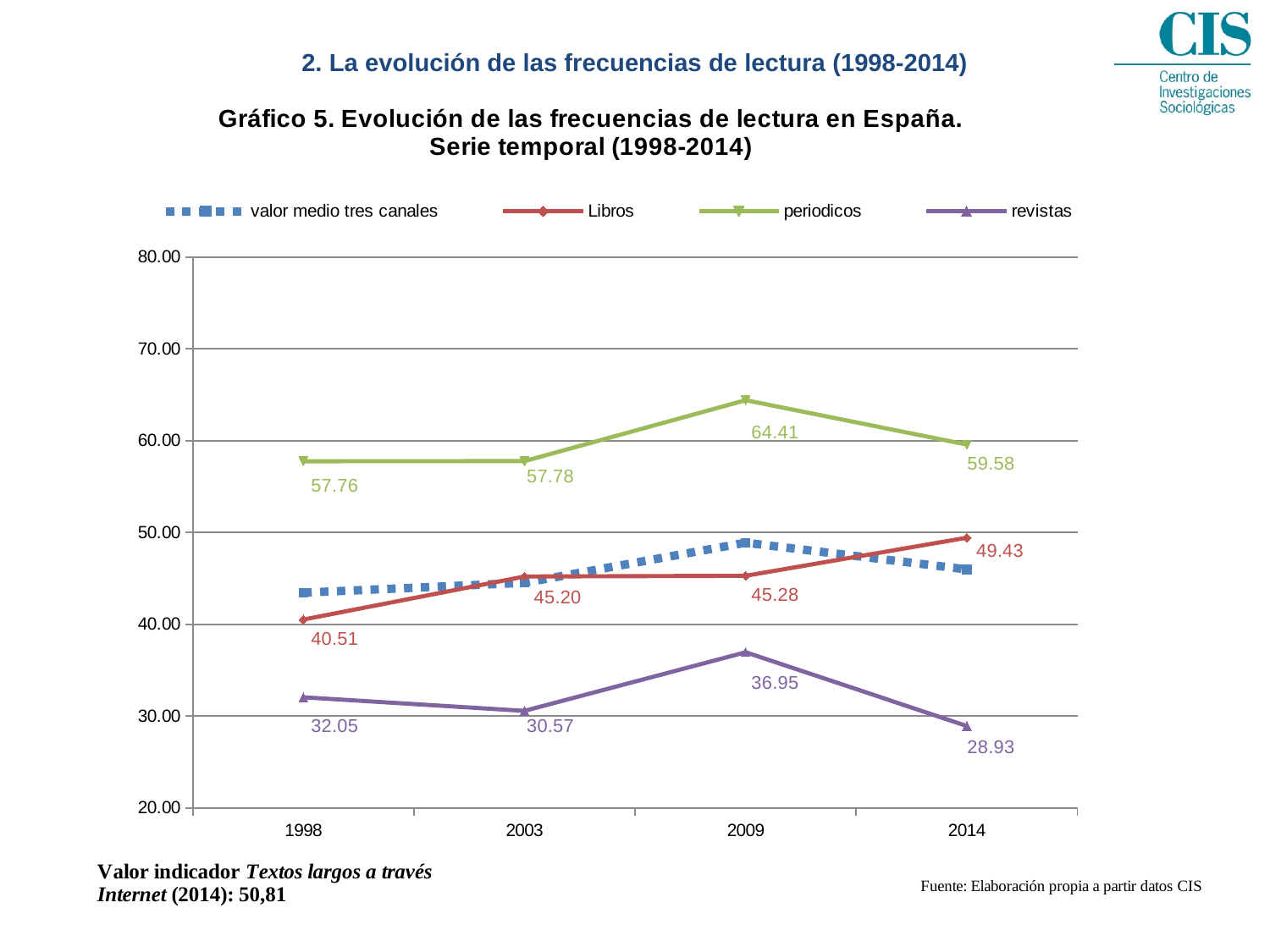
What type of chart is shown on the slide? line chart What is the value for periodicos in 2009? 64.41 What is the value for Libros in 1998? 40.51 Is the value for valor medio tres canales in 2009 greater or less than 40.00? greater In which year is the value for periodicos highest? 2009 Does the value for Libros rise or fall from 1998 to 2014? rise Which is larger in 2003, the value for Libros or the value for revistas? Libros How many series does the legend list? 4 What is the value for revistas in 2014? 28.93 How many years are plotted along the x axis? 4 What is the difference between the Libros values in 2014 and 1998? 8.92 In which year is the value for revistas lowest? 2014